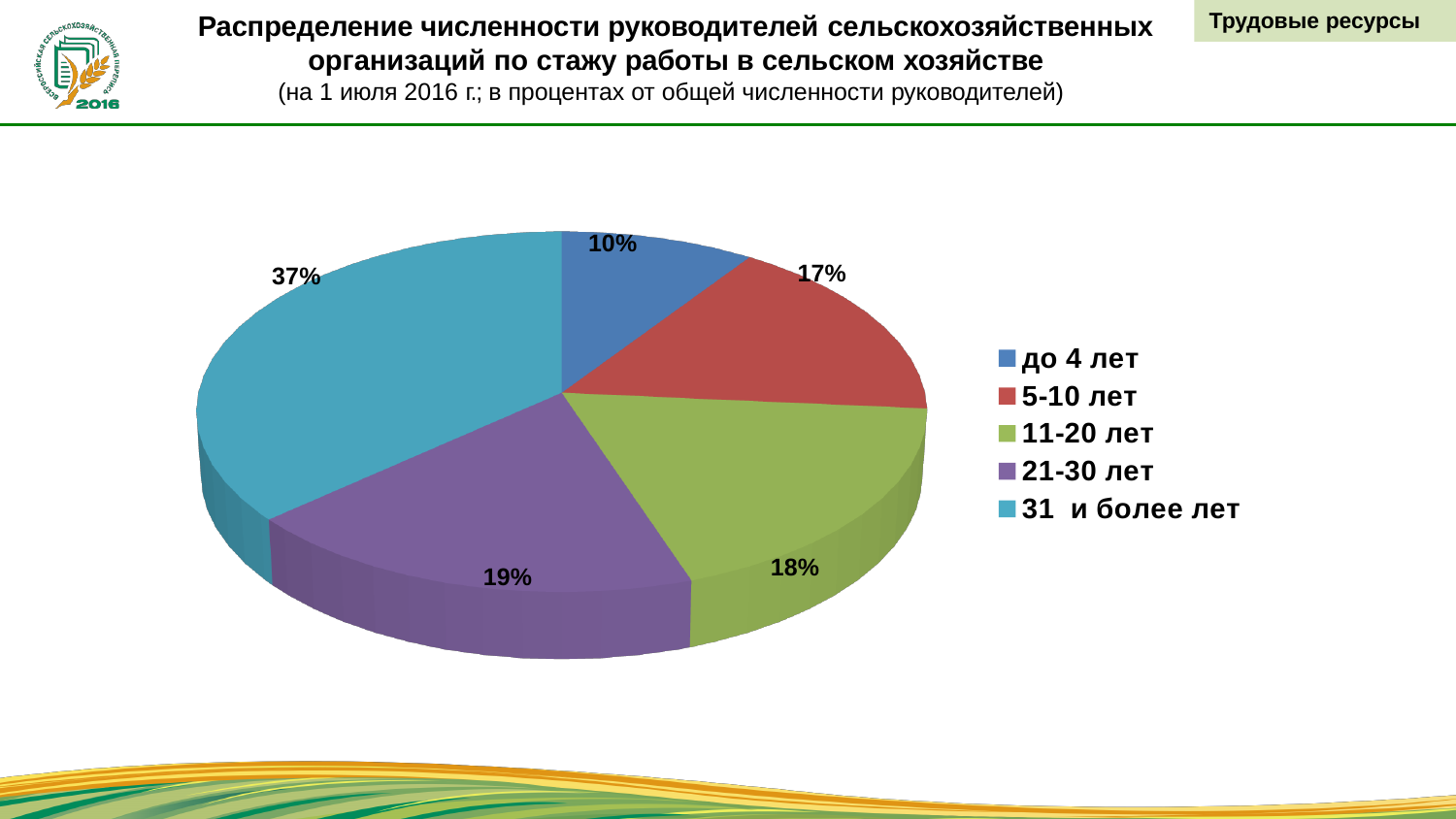
What share of managers have up to 4 years of experience (до 4 лет)? 10% What kind of chart is shown on the slide? pie chart How many categories does the pie chart have? 5 What is the difference in percentage points between the share for 31 и более лет and the share for до 4 лет? 27 Which experience category has the largest share of managers? 31 и более лет What share of managers have 11-20 years of experience (11-20 лет)? 18% Which is larger: the share for 21-30 лет or the share for 11-20 лет? 21-30 лет What share of managers have 31 or more years of experience (31 и более лет)? 37% What share of managers have 21-30 years of experience (21-30 лет)? 19% What colour is the slice for 31 и более лет? light blue (teal) What share of managers have 5-10 years of experience (5-10 лет)? 17% Which experience category has the smallest share of managers? до 4 лет